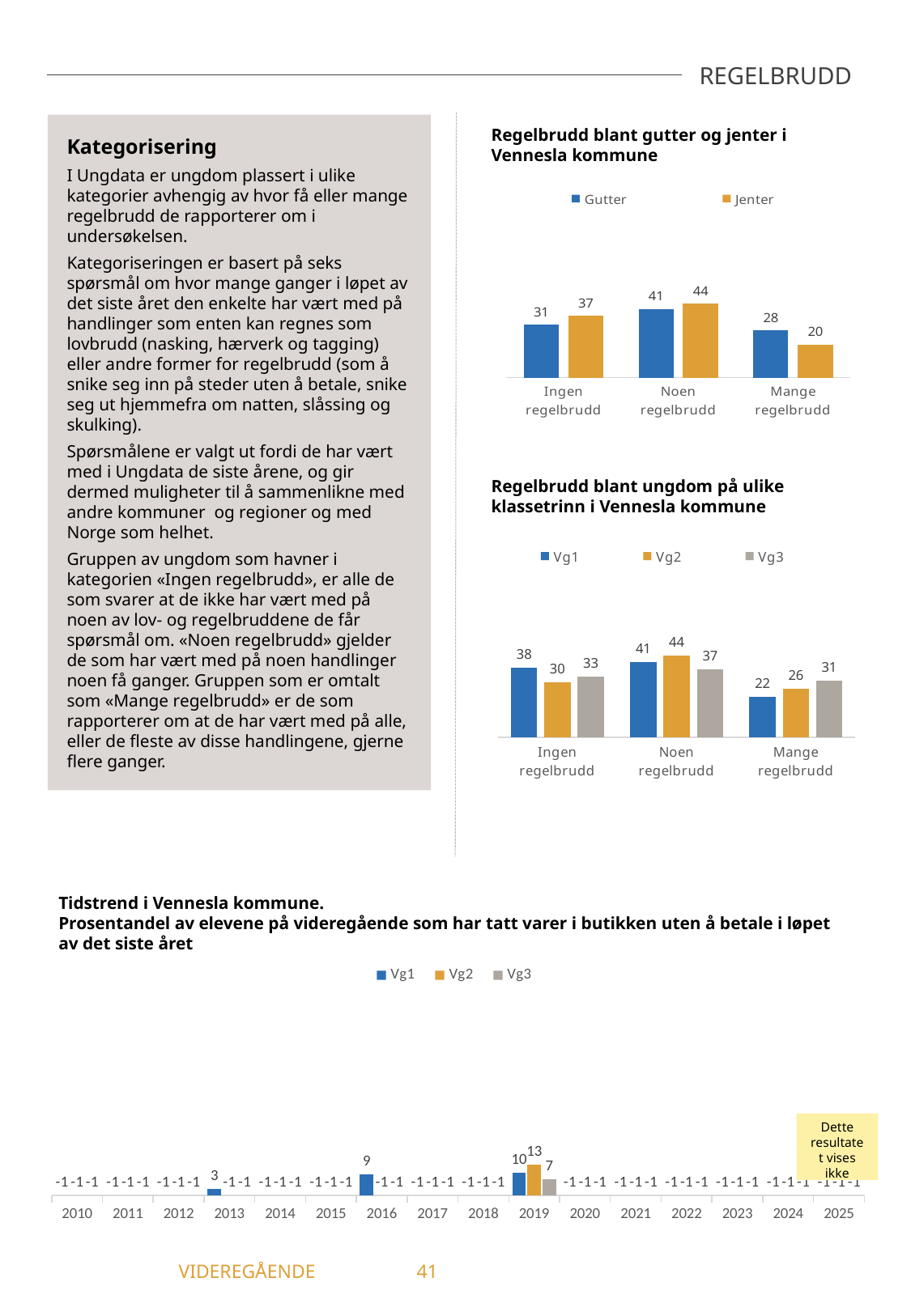
In the chart 'Regelbrudd blant gutter og jenter i Vennesla kommune', what is the difference between Jenter and Gutter in the 'Ingen regelbrudd' category? 6 In the chart 'Tidstrend i Vennesla kommune', what is the value for Vg2 in 2019? 13 In the chart 'Regelbrudd blant gutter og jenter i Vennesla kommune', how many series does the legend list? 2 In the chart 'Tidstrend i Vennesla kommune', what is the value for Vg1 in 2016? 9 In the chart 'Regelbrudd blant ungdom på ulike klassetrinn i Vennesla kommune', what is the value for Vg3 in the 'Ingen regelbrudd' category? 33 What kind of chart is 'Regelbrudd blant ungdom på ulike klassetrinn i Vennesla kommune'? Bar chart In the chart 'Regelbrudd blant gutter og jenter i Vennesla kommune', what is the value for Jenter in the 'Noen regelbrudd' category? 44 In the chart 'Regelbrudd blant ungdom på ulike klassetrinn i Vennesla kommune', which series has the highest value in the 'Noen regelbrudd' category? Vg2 In the chart 'Regelbrudd blant gutter og jenter i Vennesla kommune', what is the value for Gutter in the 'Mange regelbrudd' category? 28 In the chart 'Regelbrudd blant gutter og jenter i Vennesla kommune', which category has the lowest value for Jenter? Mange regelbrudd In the chart 'Regelbrudd blant ungdom på ulike klassetrinn i Vennesla kommune', is the value for Vg1 or Vg3 larger in the 'Mange regelbrudd' category? Vg3 In the chart 'Regelbrudd blant ungdom på ulike klassetrinn i Vennesla kommune', what is the difference between Vg1 and Vg2 in the 'Ingen regelbrudd' category? 8